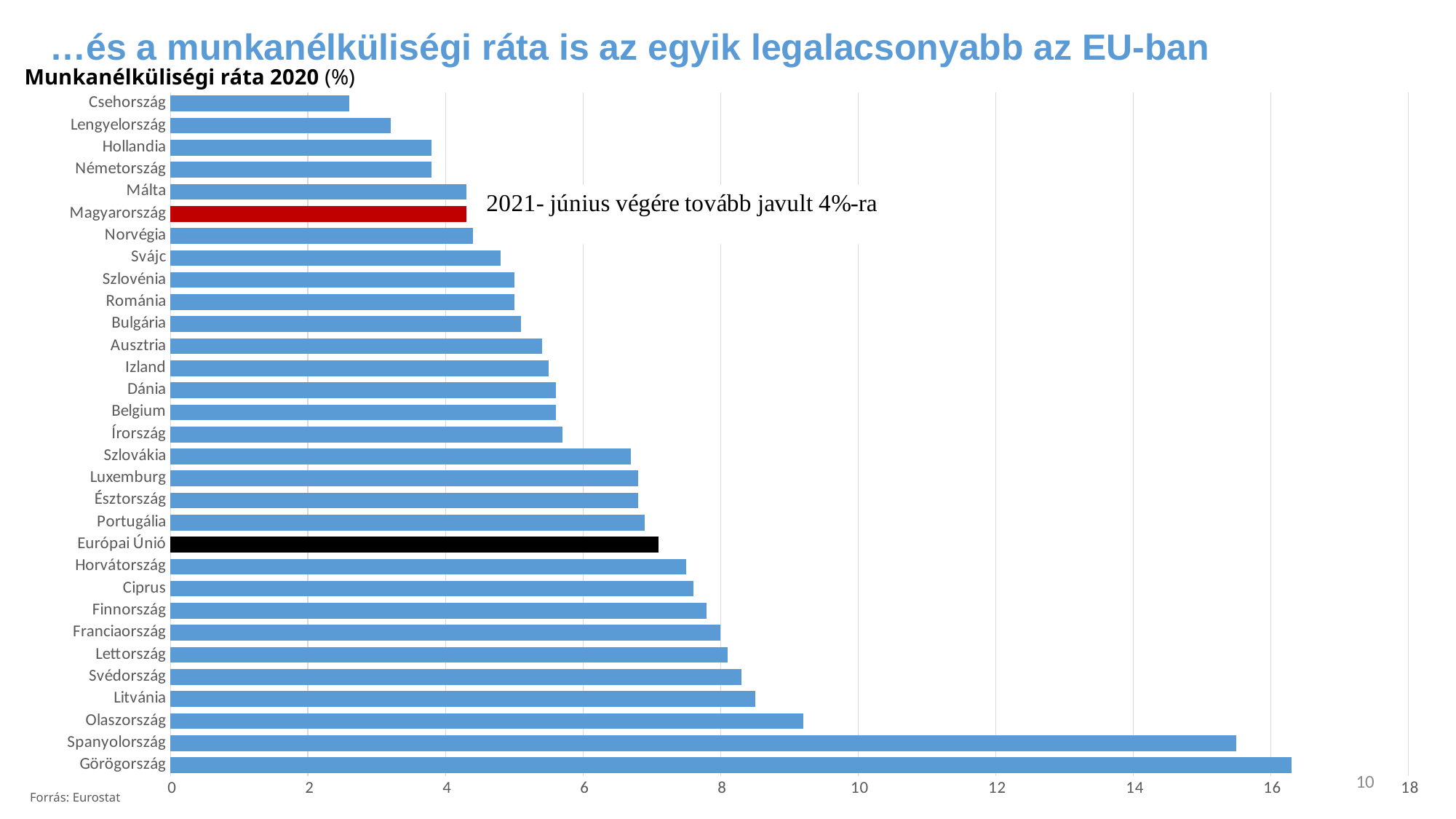
Is the value for Európai Únió greater or less than 8? less Which has a higher unemployment rate, Magyarország or Európai Únió? Európai Únió What is the title of the chart? Munkanélküliségi ráta 2020 (%) Is the value for Olaszország greater or less than 8? greater How many categories (bars) are shown in the chart? 31 Which has a higher unemployment rate, Litvánia or Lengyelország? Litvánia Which country has the lowest unemployment rate in the chart? Csehország Which country has the highest unemployment rate in the chart? Görögország Is the value for Csehország greater or less than 4? less What colour is the bar for Magyarország? red What kind of chart is shown on the slide? bar chart